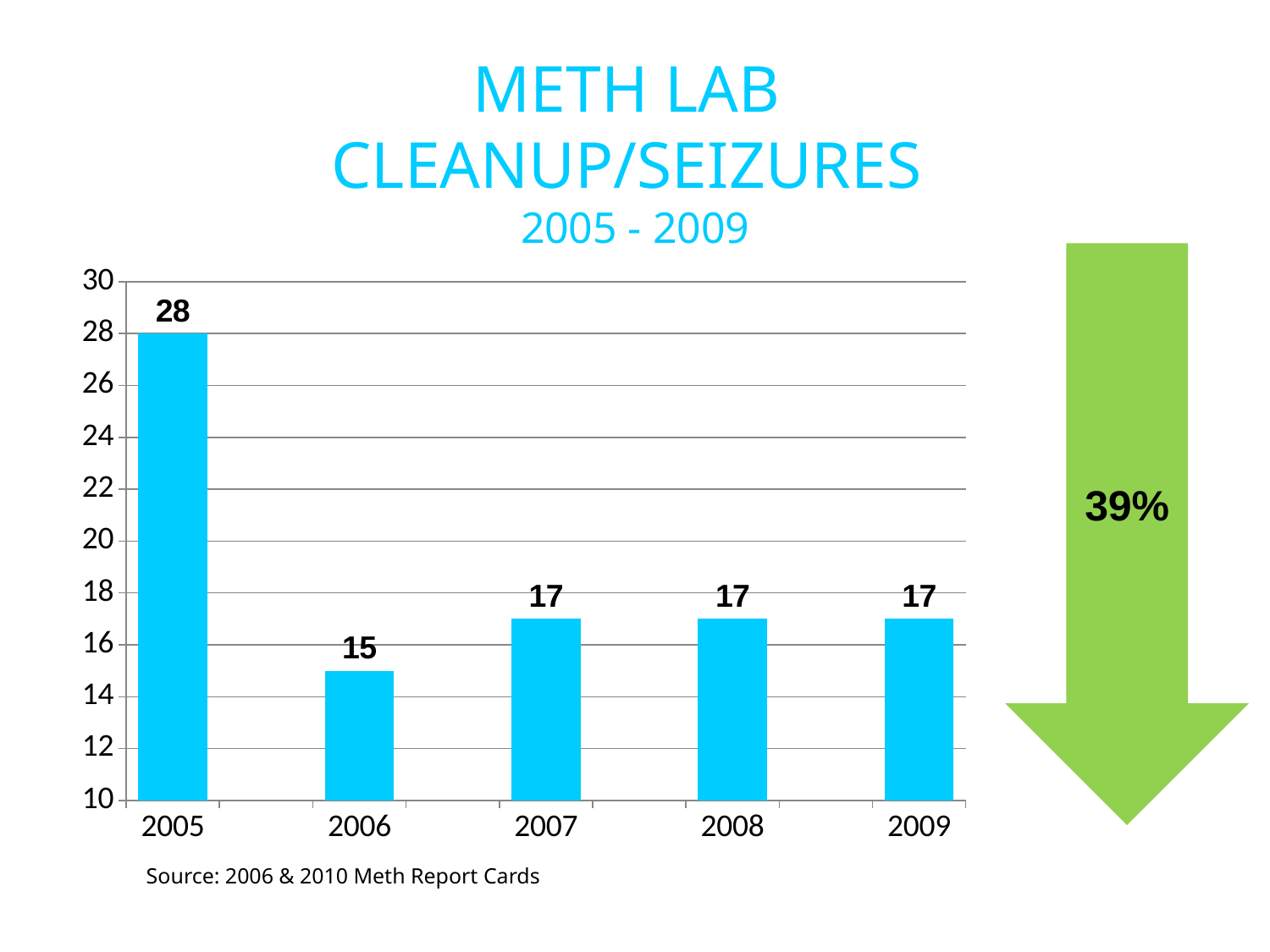
Which is larger, the value for 2005 or the value for 2006? 2005 What is the difference between the values for 2007 and 2006? 2 What percentage is shown in the green arrow next to the chart? 39% What is the difference between the values for 2005 and 2009? 11 Is the value for 2006 greater or less than 20? less What kind of chart is shown on the slide? bar chart How many years are shown on the x axis? 5 Which year has the highest value? 2005 What is the value for 2006? 15 What is the value for 2008? 17 What is the value for 2005? 28 Which year has the lowest value? 2006